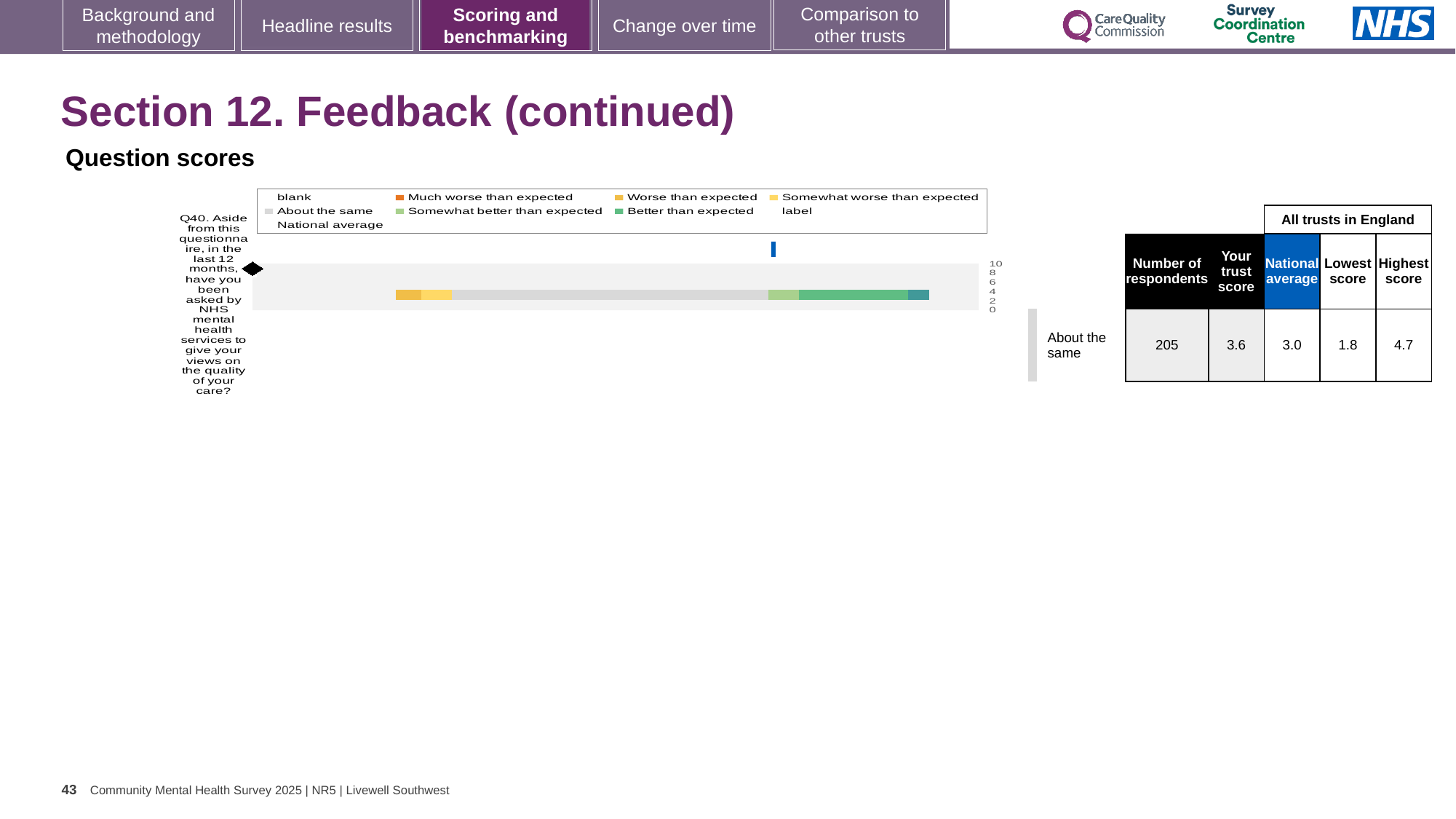
What benchmark category is the trust's Q40 score placed in? About the same How many questions (categories) are plotted in the chart? 1 What is the number of respondents for Q40? 205 Which is larger for Q40, the trust's score or the national average? the trust's score What is the trust's score for Q40? 3.6 What is the difference between the trust's score and the national average for Q40? 0.6 What is the highest score among all trusts in England for Q40? 4.7 Which legend entry is shown in the darkest green colour? Better than expected What is the national average score for Q40? 3.0 What is the difference between the highest and lowest scores among all trusts in England for Q40? 2.9 What is the lowest score among all trusts in England for Q40? 1.8 What kind of chart is shown for Q40 on this slide? bar chart